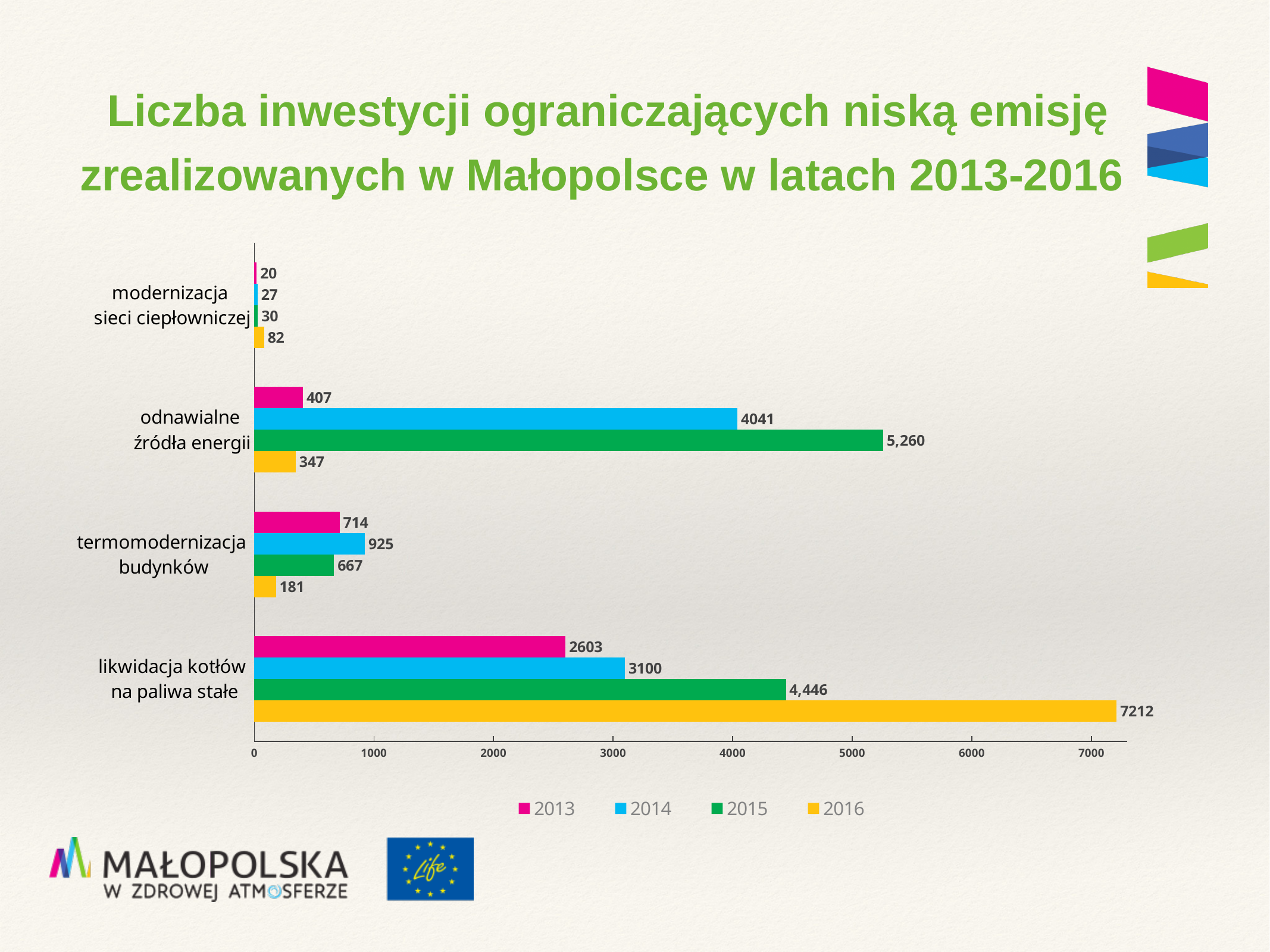
What is the value for 2014 in the 'termomodernizacja budynków' category? 925 What is the value for 2015 in the 'odnawialne źródła energii' category? 5,260 What is the value for 2013 in the 'modernizacja sieci ciepłowniczej' category? 20 How many categories are shown on the chart? 4 What is the value for 2016 in the 'likwidacja kotłów na paliwa stałe' category? 7212 Is the 2015 value for 'likwidacja kotłów na paliwa stałe' greater or less than 4000? greater What kind of chart is shown on the slide? bar chart Which year has the lowest value in the 'odnawialne źródła energii' category? 2016 Which is larger in the 'termomodernizacja budynków' category: the 2013 value or the 2015 value? 2013 Which year has the highest value in the 'likwidacja kotłów na paliwa stałe' category? 2016 How many series does the legend list? 4 What is the difference between the 2014 and 2013 values for 'likwidacja kotłów na paliwa stałe'? 497